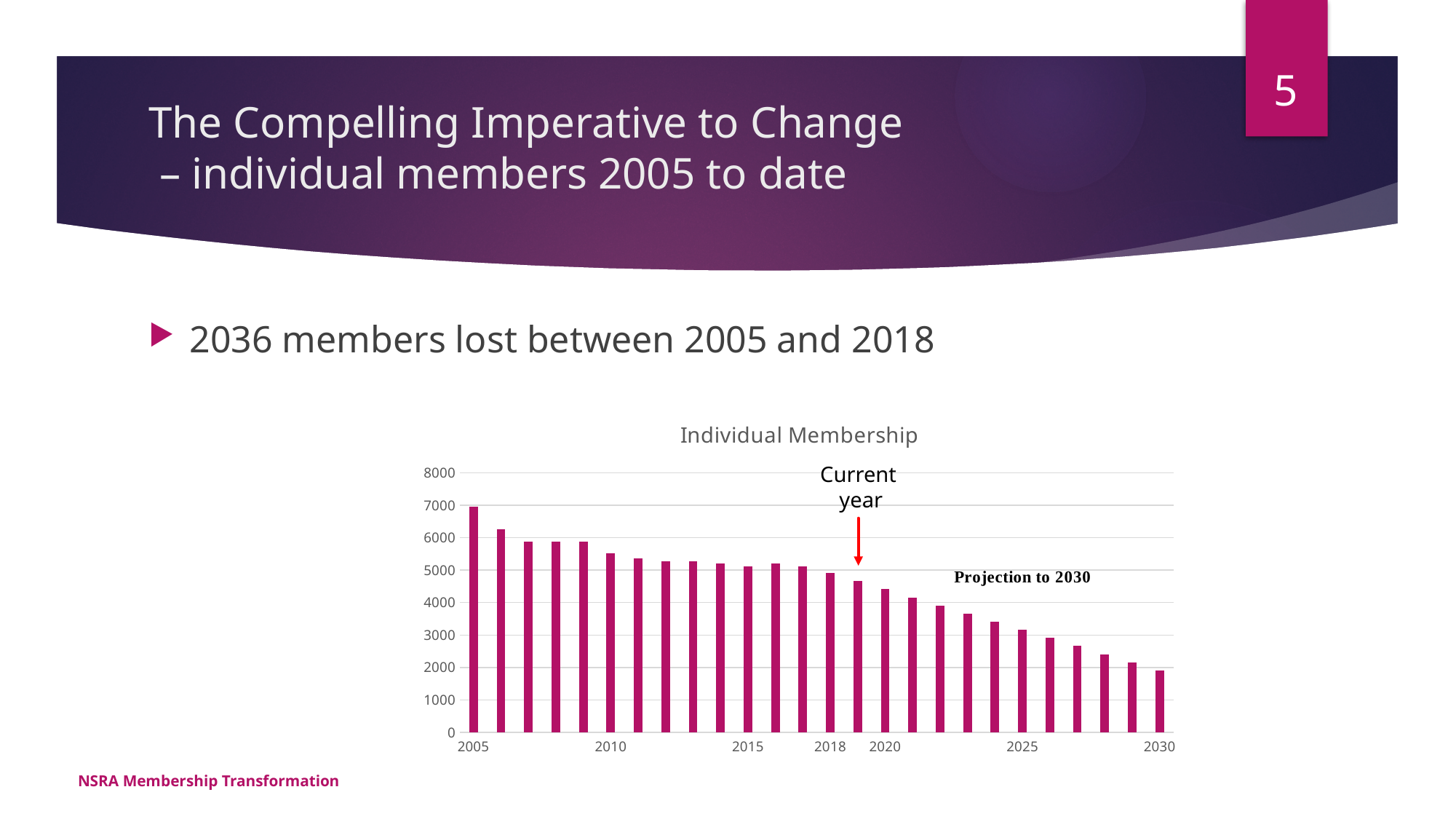
Do the membership values rise or fall from 2005 to 2030? Fall Is the value for 2005 greater or less than 6000? greater Which year has the highest individual membership in the chart? 2005 Is the value for 2020 greater or less than 4000? greater What is the title of the chart? Individual Membership What text annotation appears above the bars on the right side of the chart? Projection to 2030 Which is larger, the value for 2010 or the value for 2020? 2010 Is the value for 2010 greater or less than 5000? greater Which year has the lowest individual membership in the chart? 2030 How many bars are plotted in the chart? 26 What kind of chart is shown on the slide? Bar chart